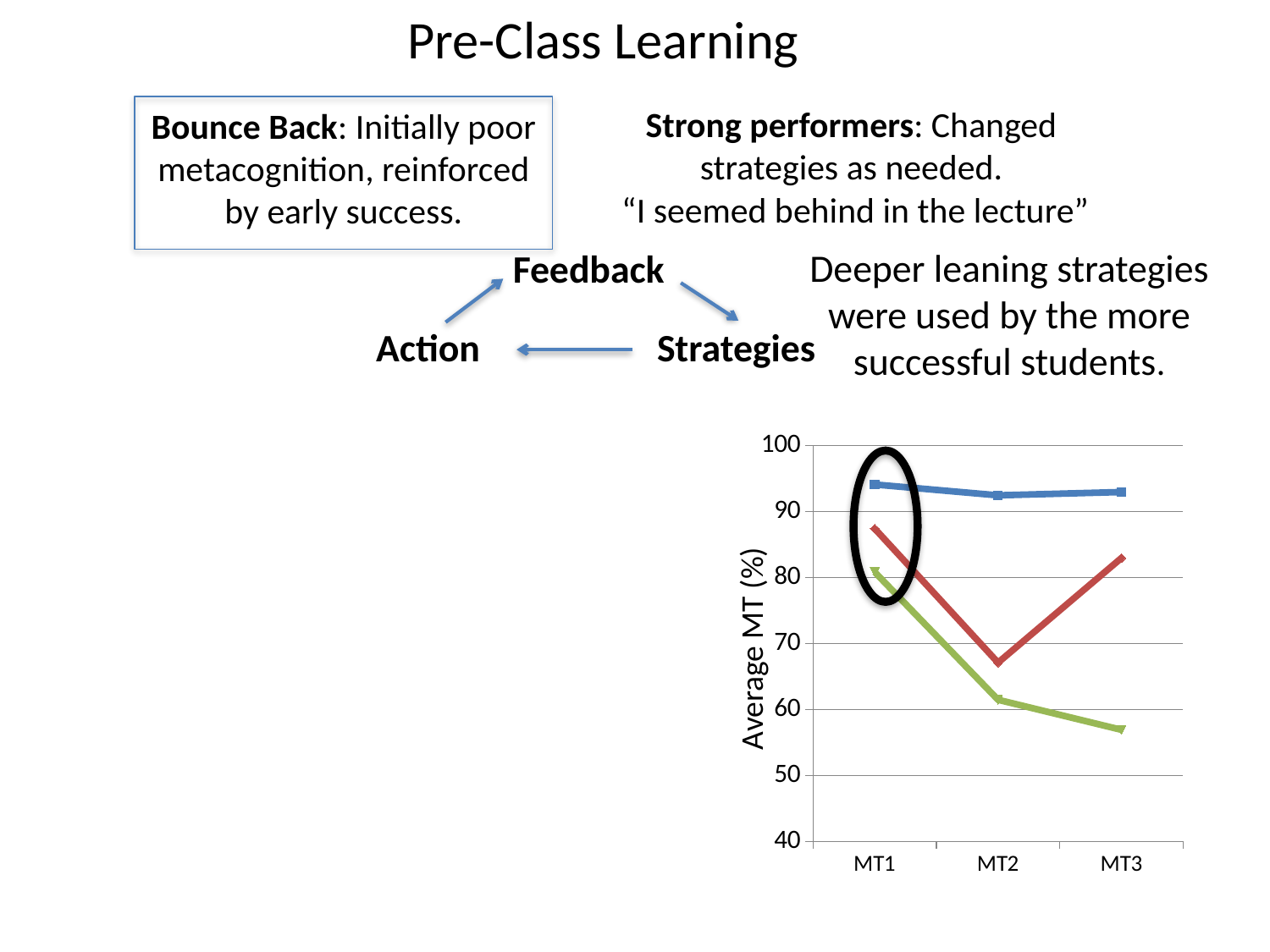
What is the label of the y axis of the chart? Average MT (%) What kind of chart is shown on the slide? line chart Is the value of the red line at MT3 greater or less than 80? greater Does the green line rise or fall from MT1 to MT3? fall Is the value of the red line at MT2 greater or less than 70? less Which line has the lowest value at MT2? the green line Which line has the highest value at MT3? the blue line How many categories are shown on the x axis of the chart? 3 Is the value of the green line at MT3 greater or less than 60? less At MT3, which is larger: the value of the red line or the value of the green line? the red line